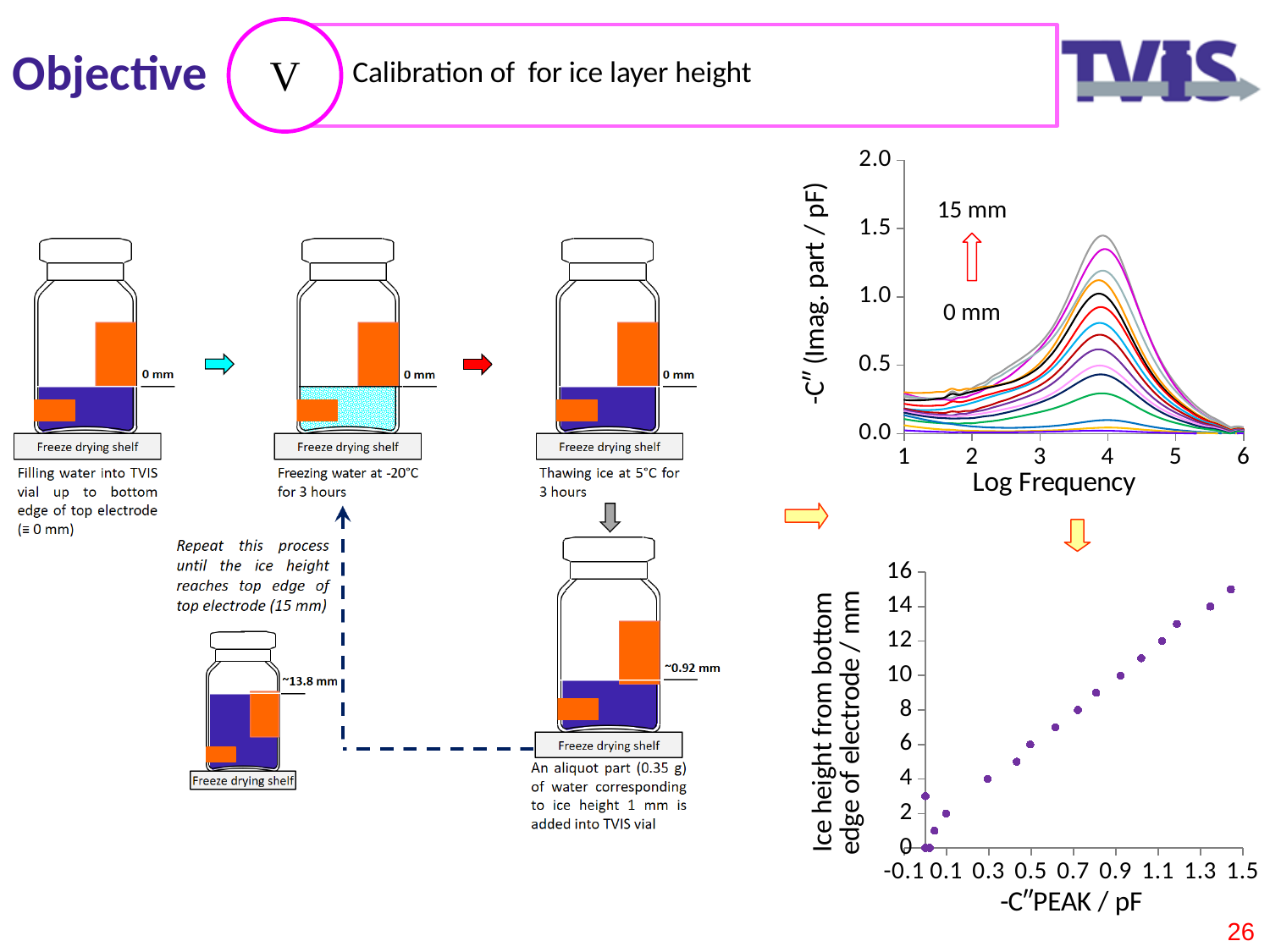
In the top-right chart, is the peak value of the highest curve greater or less than 1.0 pF? greater In the top-right chart, which ice height label is placed at the top of the arrow, indicating the highest curves? 15 mm What kind of chart is the top-right chart plotting -C″ against Log Frequency? line chart In the bottom-right chart, is the -C″PEAK value of the point at 10 mm ice height greater or less than 1.1 pF? less What is the maximum value shown on the y axis of the top-right chart? 2.0 In the bottom-right chart, is the -C″PEAK value of the highest point (at about 15 mm) greater or less than 1.3 pF? greater In the bottom-right chart, do the ice height values rise or fall as -C″PEAK increases along the x axis? rise What is the maximum value shown on the x axis of the bottom-right chart? 1.5 What kind of chart is the bottom-right chart plotting ice height against -C″PEAK? scatter chart What is the x-axis label of the top-right chart? Log Frequency